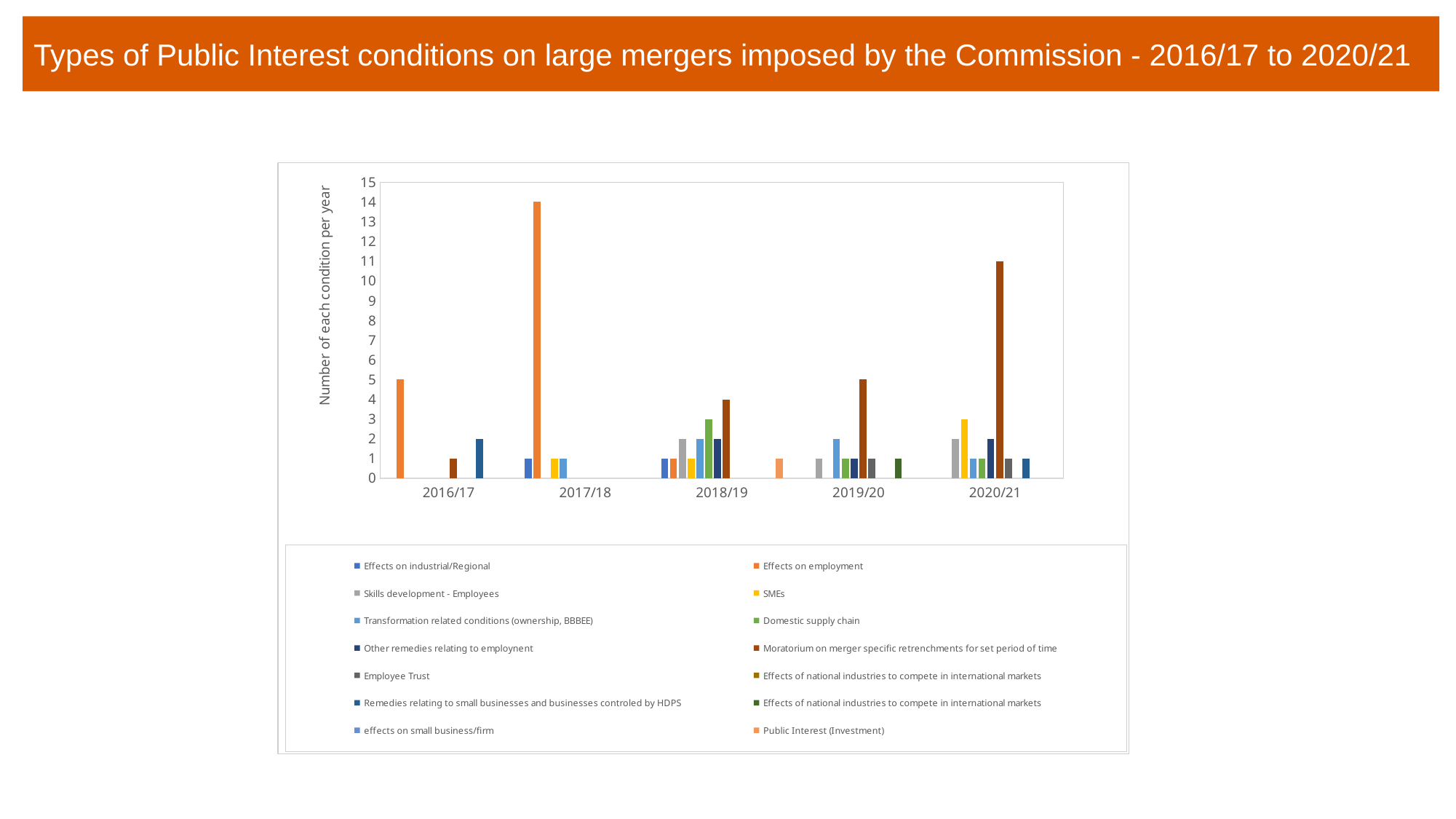
How many series does the legend list? 14 What is the value for Effects on employment in 2016/17? 5 What type of chart is shown on the slide? Bar chart How many year categories are shown on the x axis? 5 Which is larger: Effects on employment in 2017/18 or Moratorium on merger specific retrenchments for set period of time in 2020/21? Effects on employment in 2017/18 In which year does the tallest bar on the chart appear? 2017/18 What is the value for Effects on employment in 2017/18? 14 What is the title of the y axis? Number of each condition per year What is the value for Moratorium on merger specific retrenchments for set period of time in 2020/21? 11 What is the difference between Effects on employment in 2017/18 and Moratorium on merger specific retrenchments for set period of time in 2020/21? 3 What is the value for Moratorium on merger specific retrenchments for set period of time in 2019/20? 5 Is the value for Effects on employment in 2017/18 greater or less than 10? greater